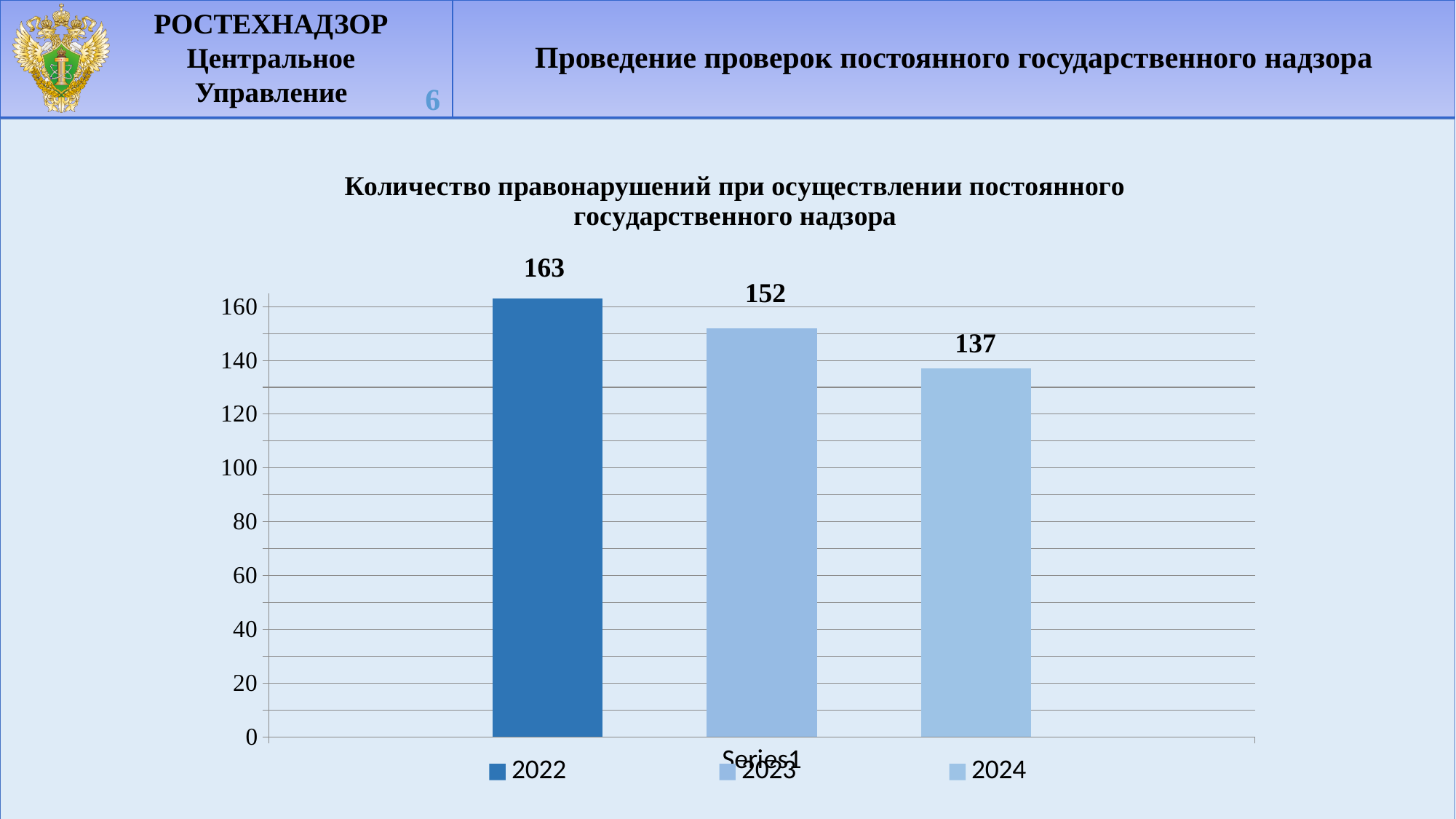
What is the value for 2023? 152 Is the value for 2024 greater or less than 140? less What is the value for 2024? 137 Which is larger, the value for 2022 or the value for 2023? 2022 How many series does the legend list? 3 What is the difference between the values for 2023 and 2024? 15 Which year has the lowest value? 2024 Which year has the highest value? 2022 What is the value for 2022? 163 What is the difference between the values for 2022 and 2024? 26 What kind of chart is shown on the slide? bar chart Do the values rise or fall from 2022 to 2024? fall